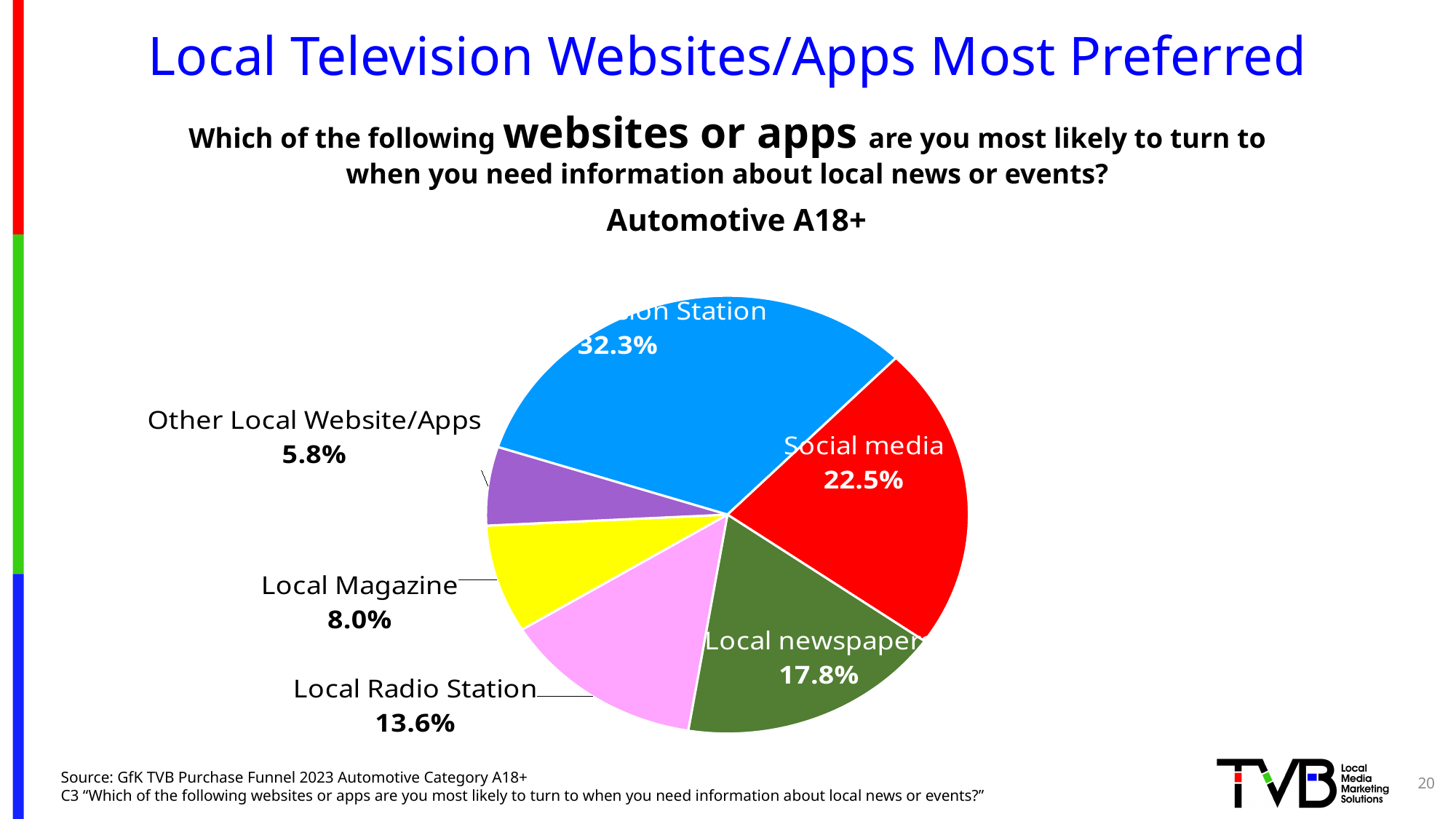
What is the largest percentage value shown on the pie chart? 32.3% What is the difference in percentage points between Local Magazine and Other Local Website/Apps? 2.2% What share of the pie does Local Radio Station account for? 13.6% What percentage is shown for Local newspaper? 17.8% Which is larger, Local Radio Station or Local Magazine? Local Radio Station What is the difference in percentage points between Social media and Local newspaper? 4.7% What type of chart is shown on the slide? Pie chart How many slices does the pie chart have? 6 What percentage is shown for Social media? 22.5% What percentage is shown for Other Local Website/Apps? 5.8% What percentage is shown for Local Magazine? 8.0% Which category has the smallest slice of the pie? Other Local Website/Apps